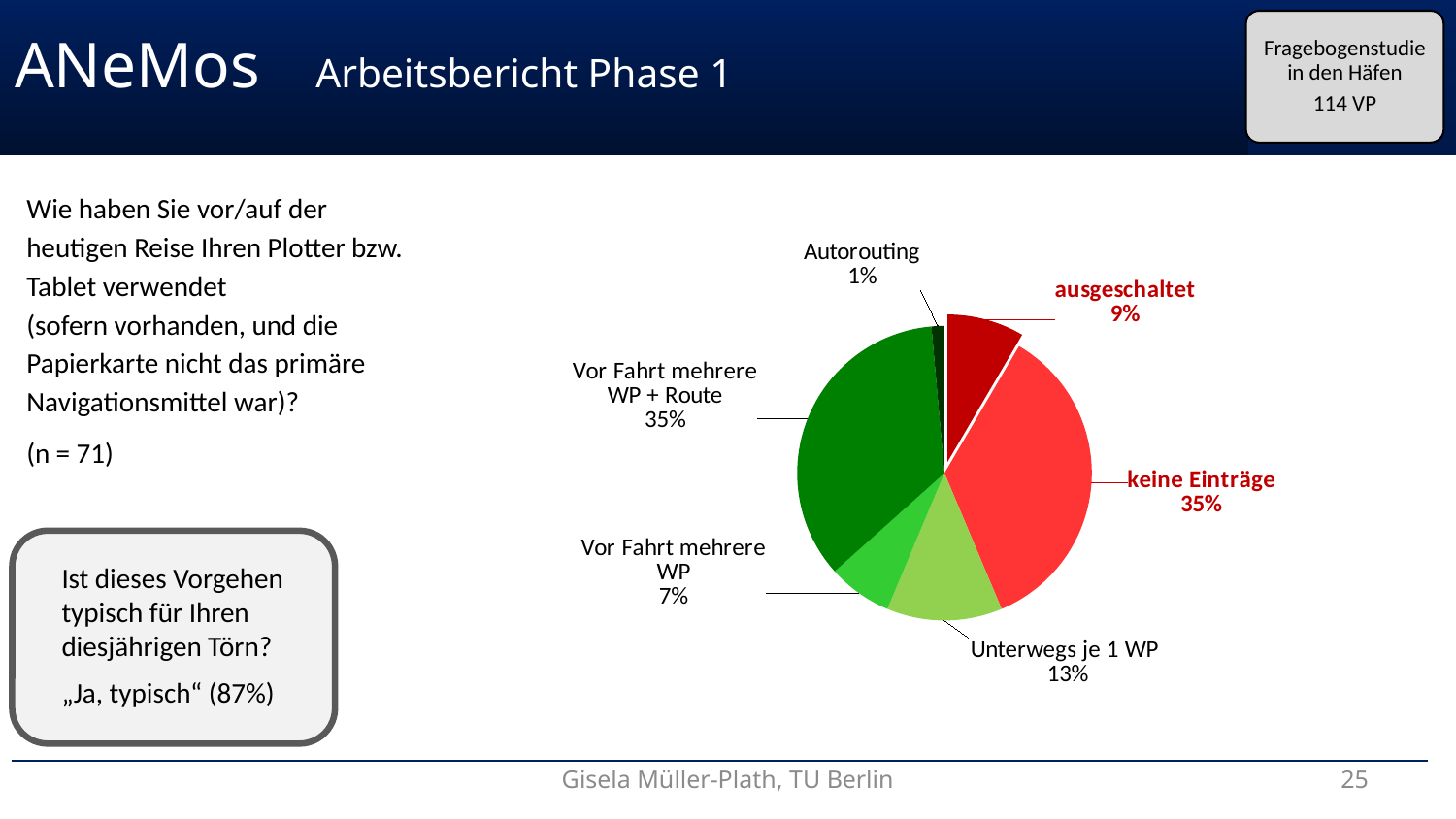
What kind of chart is shown on the slide? pie chart What share is shown for "Vor Fahrt mehrere WP + Route"? 35% Which slice of the pie is the smallest? Autorouting What is the difference in percentage points between "keine Einträge" and "Unterwegs je 1 WP"? 22 percentage points What is the value shown for "Autorouting"? 1% How many slices does the pie chart have? 6 What share of the pie does "keine Einträge" have? 35% What percentage is shown for "Unterwegs je 1 WP"? 13% Which two slice labels are printed in red bold text? ausgeschaltet and keine Einträge What is the value for "ausgeschaltet"? 9% Which is larger, "ausgeschaltet" or "Vor Fahrt mehrere WP"? ausgeschaltet What is the combined share of "ausgeschaltet" and "keine Einträge"? 44%